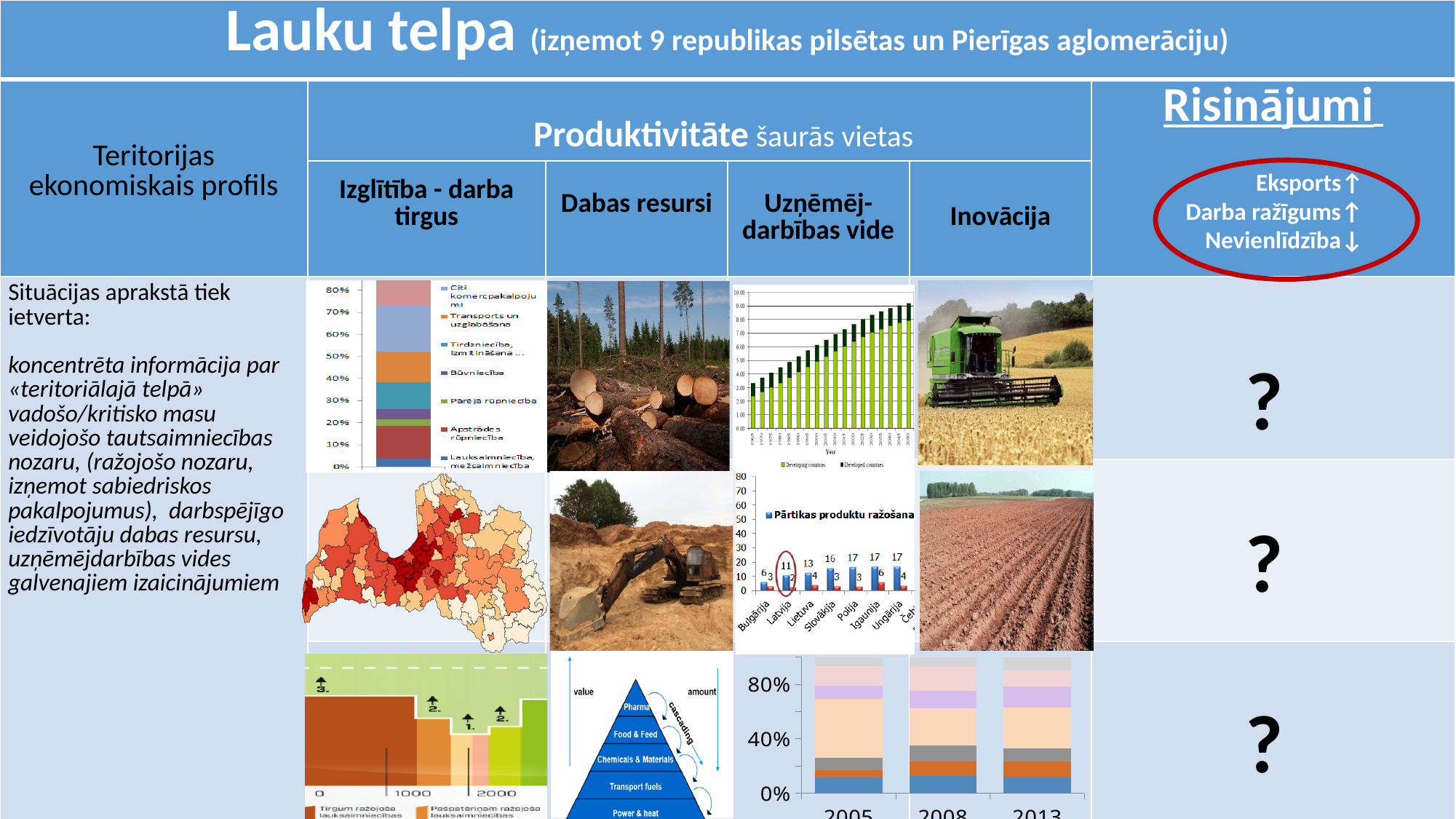
In the 'Pārtikas produktu ražošana' bar chart, is the blue bar for Bulgārija greater or less than 10? less In the 'Pārtikas produktu ražošana' bar chart, which country has the lowest red bar? Latvija In the 'Pārtikas produktu ražošana' bar chart, which has the larger blue bar, Lietuva or Latvija? Lietuva In the 'Pārtikas produktu ražošana' bar chart, what is the value of the blue bar for Latvija? 11 In the 'Pārtikas produktu ražošana' bar chart, what is the value of the blue bar for Lietuva? 13 In the 'Pārtikas produktu ražošana' bar chart, what is the difference between the blue bars for Slovākija and Latvija? 5 How many years are shown on the x axis of the stacked bar chart at the bottom of the 'Uzņēmējdarbības vide' column? 3 How many series does the legend of the stacked percentage bar chart in the 'Izglītība - darba tirgus' column list? 7 In the chart at the top of the 'Uzņēmējdarbības vide' column with years on the x axis, do the bar heights rise or fall from left to right? rise In the 'Pārtikas produktu ražošana' bar chart, which country has the lowest blue bar? Bulgārija What kind of chart is the 'Pārtikas produktu ražošana' chart? bar chart In the 'Pārtikas produktu ražošana' bar chart, what is the value of the red bar for Igaunija? 6